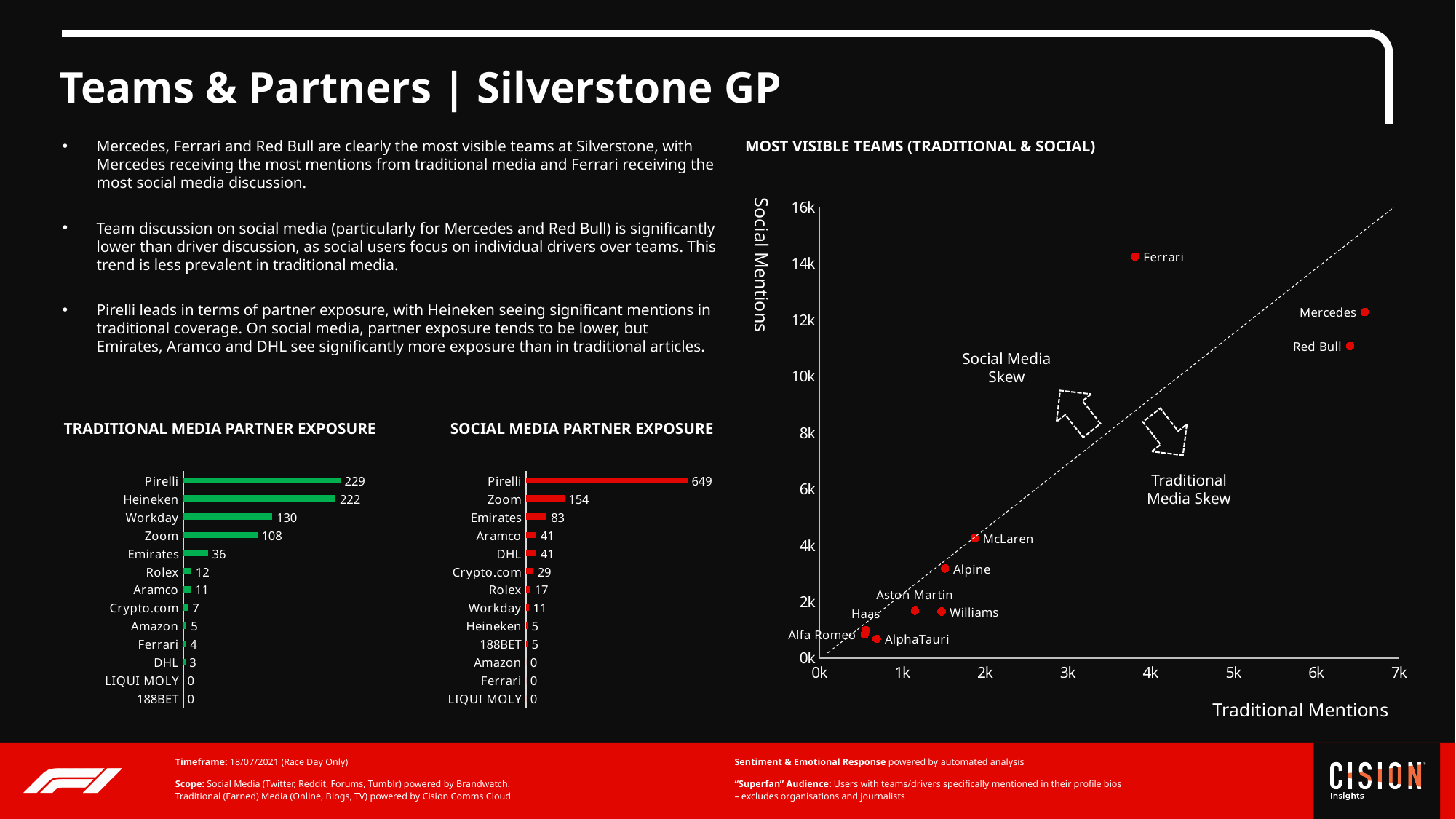
In the Most Visible Teams chart, which team has the highest number of Traditional Mentions? Mercedes What is the label of the x axis of the Most Visible Teams chart? Traditional Mentions In the Social Media Partner Exposure chart, what is the difference between Pirelli and Zoom? 495 In the Social Media Partner Exposure chart, what is the value for Emirates? 83 In the Social Media Partner Exposure chart, what is the value for Zoom? 154 In the Traditional Media Partner Exposure chart, which partner has the highest value? Pirelli What kind of chart is the Most Visible Teams (Traditional & Social) chart? Scatter chart In the Most Visible Teams chart, is the value of Social Mentions for Ferrari greater or less than 12k? greater In the Traditional Media Partner Exposure chart, what is the difference between Pirelli and Workday? 99 In the Traditional Media Partner Exposure chart, how many partners are listed? 13 In the Social Media Partner Exposure chart, which is larger, the value for Aramco or the value for Crypto.com? Aramco In the Traditional Media Partner Exposure chart, what is the value for Heineken? 222